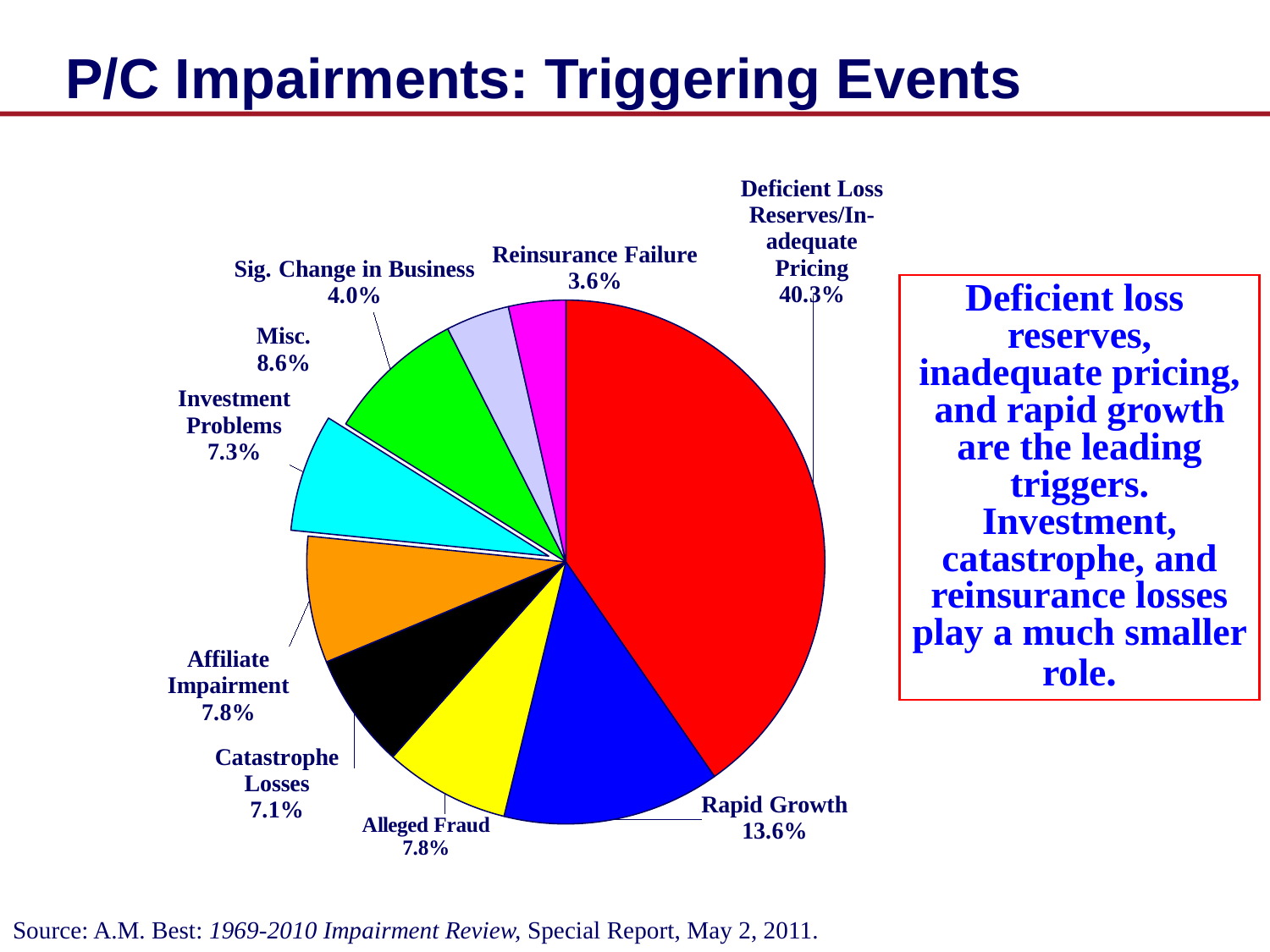
Which triggering event has the largest share of the pie? Deficient Loss Reserves/Inadequate Pricing How many slices does the pie chart have? 9 What is the value for Catastrophe Losses? 7.1% What is the combined share of Alleged Fraud and Affiliate Impairment? 15.6% Which triggering event has the smallest share of the pie? Reinsurance Failure Which is larger, the share for Misc. or the share for Investment Problems? Misc. What is the difference in percentage points between Deficient Loss Reserves/Inadequate Pricing and Rapid Growth? 26.7 What colour is the slice for Rapid Growth? blue What kind of chart is shown on the slide? pie chart What percentage is shown for Misc.? 8.6% What share of P/C impairments is attributed to Rapid Growth? 13.6% What percentage is shown for Deficient Loss Reserves/Inadequate Pricing? 40.3%